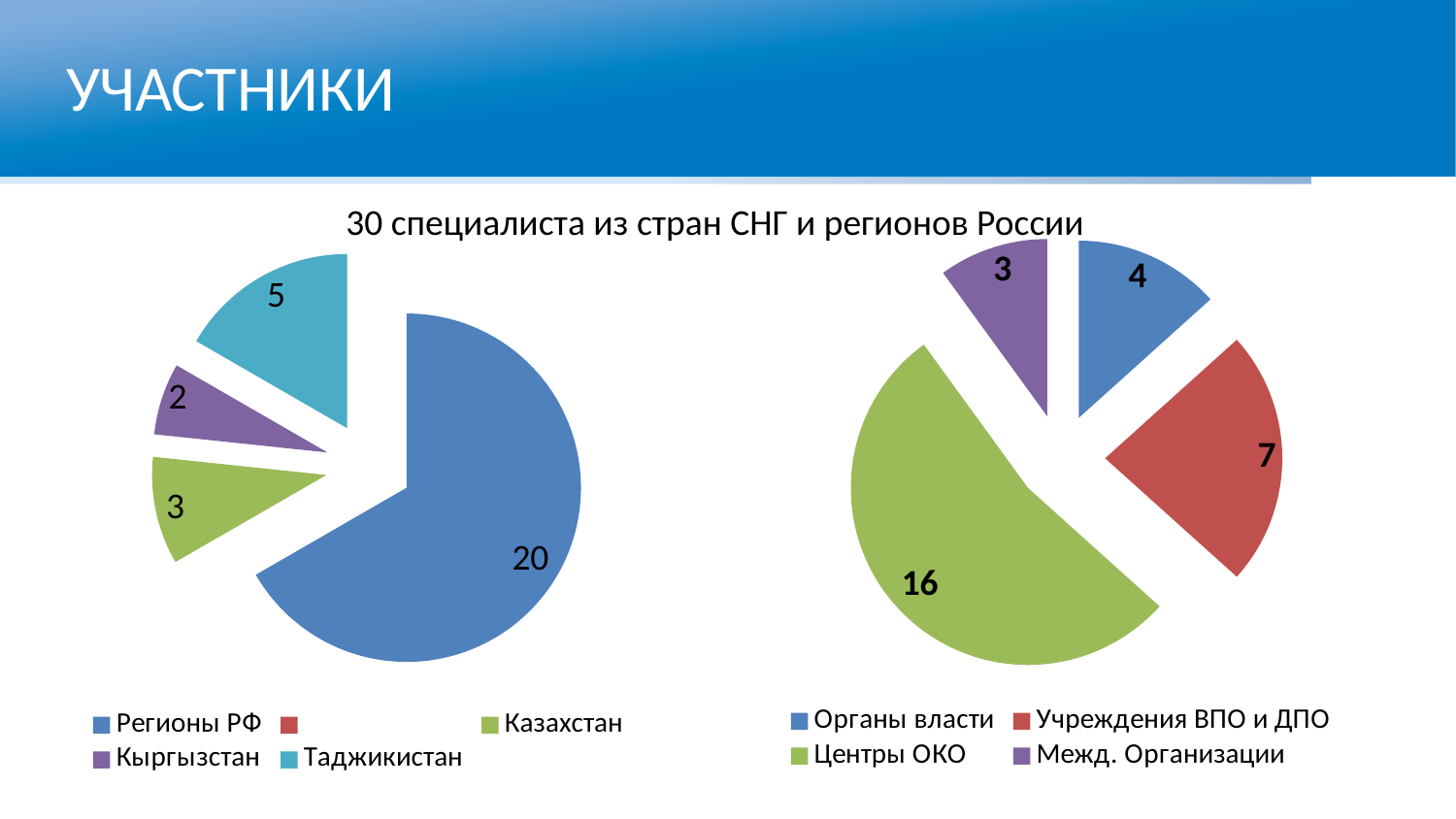
In the left pie chart, which category has the smallest slice? Кыргызстан In the right pie chart, which is larger: Органы власти or Учреждения ВПО и ДПО? Учреждения ВПО и ДПО In the right pie chart, what is the value for Учреждения ВПО и ДПО? 7 What type of chart is shown on the right side of the slide? Pie chart In the left pie chart, what is the difference between the values for Таджикистан and Казахстан? 2 In the left pie chart, what is the value for Регионы РФ? 20 In the left pie chart, what is the value for Таджикистан? 5 In the right pie chart, what is the value for Межд. Организации? 3 In the right pie chart, which category has the largest slice? Центры ОКО How many categories does the legend of the right pie chart list? 4 In the right pie chart, what is the difference between the values for Центры ОКО and Органы власти? 12 In the left pie chart, what share of the total does Регионы РФ represent? 2/3